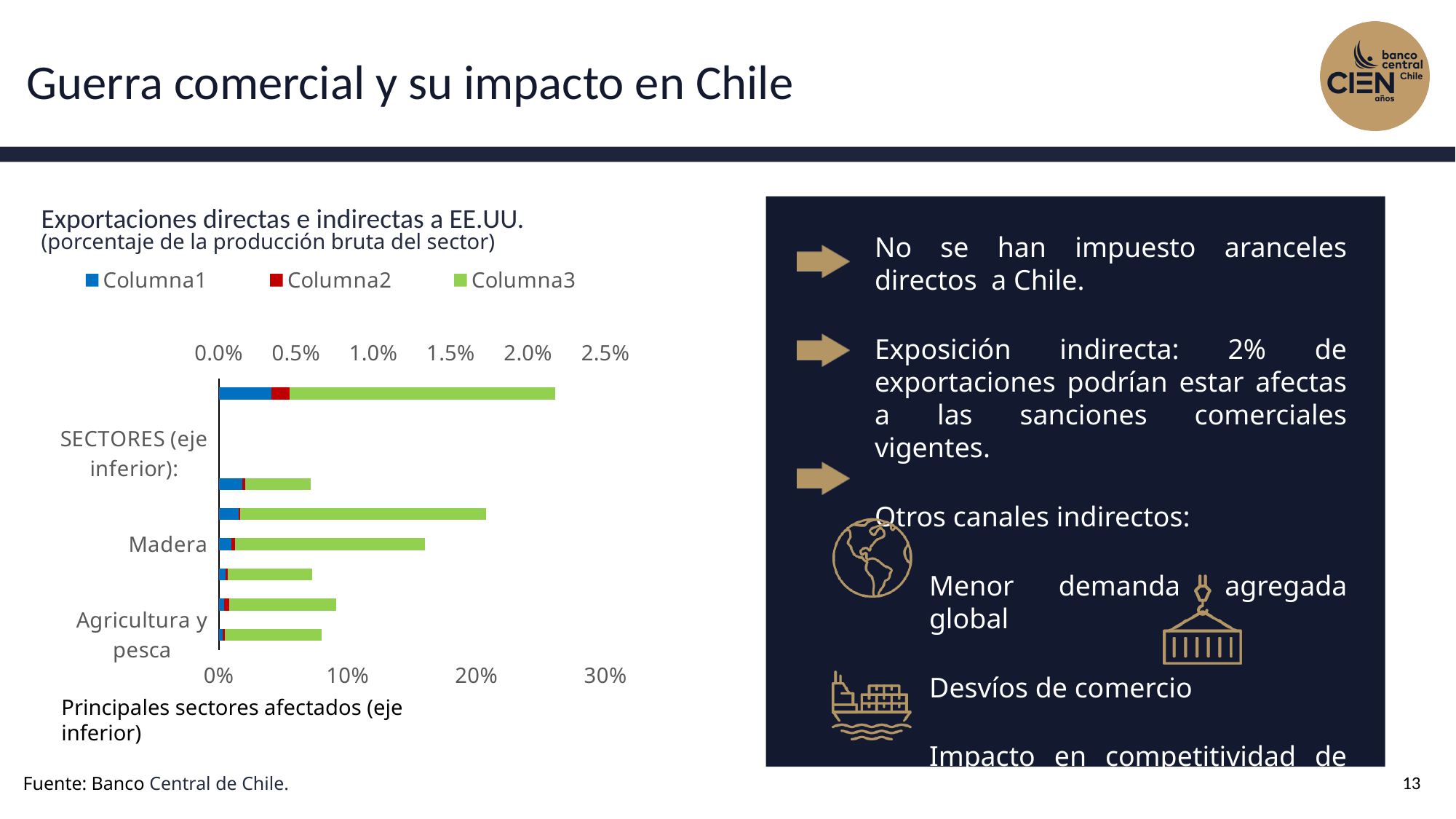
Which of the two labelled sectors, Madera or Agricultura y pesca, has the longer bar? Madera On the bottom axis, is the total bar for Madera greater or less than 20%? less How many bars are plotted in the chart? 7 What is the title of the chart? Exportaciones directas e indirectas a EE.UU. Which series accounts for the largest portion of each stacked bar? Columna3 On the bottom axis, is the total bar for Madera greater or less than 10%? greater How many series does the chart legend list? 3 What are the three series names in the chart legend? Columna1, Columna2, Columna3 What kind of chart is shown on the slide? bar chart On the bottom axis, is the total bar for Agricultura y pesca greater or less than 10%? less